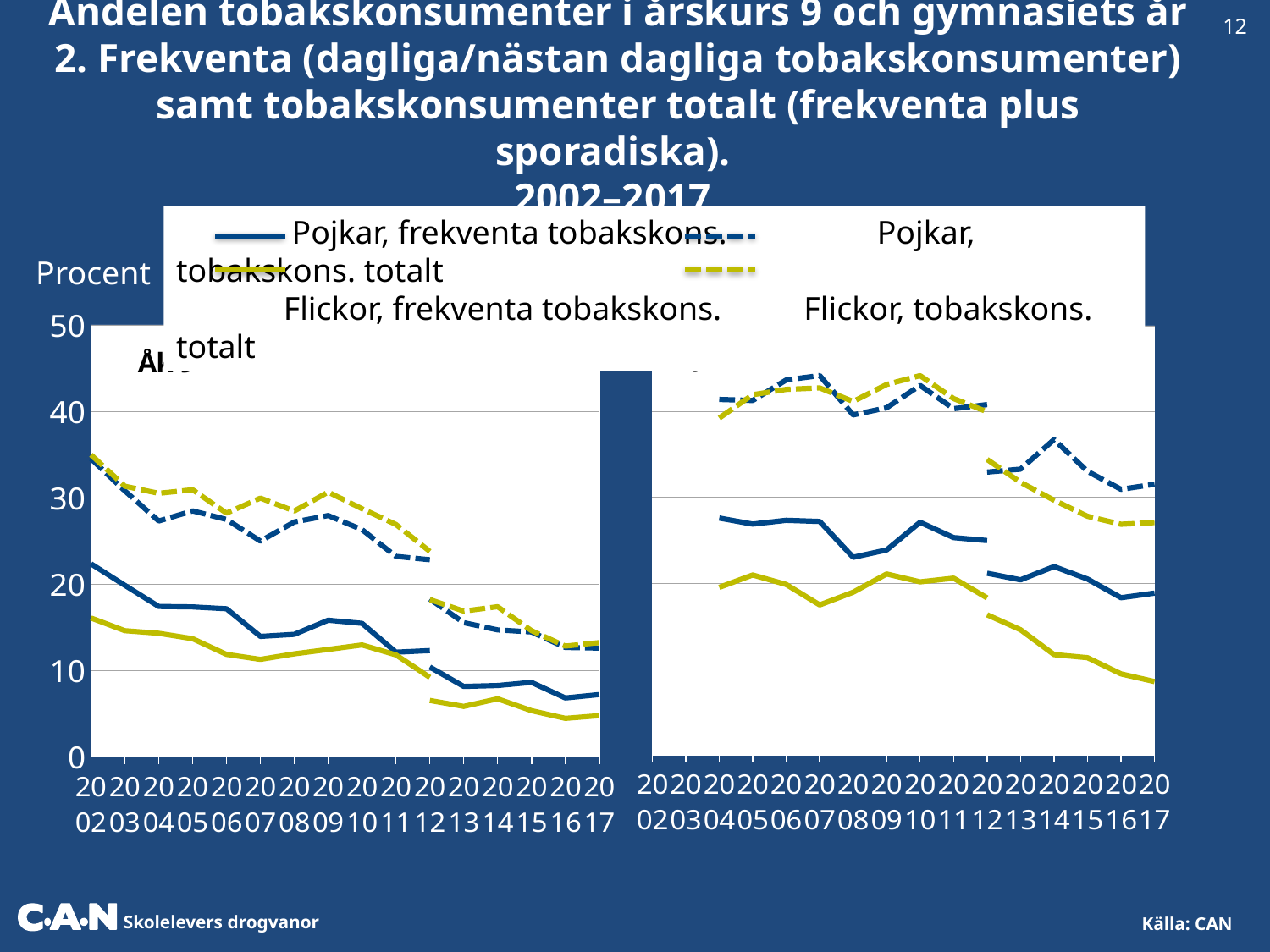
What is the label on the y axis of the charts? Procent In the left chart, is the value for Pojkar, tobakskons. totalt in 2002 greater or less than 30? greater What kind of chart is shown on the left side of the slide? Line chart In the left chart, does the Flickor, frekventa tobakskons. series rise or fall from 2002 to 2017? Fall What source is cited at the bottom of the slide? Källa: CAN In the right chart, is the value for Flickor, frekventa tobakskons. in 2017 greater or less than 10? less How many series does the legend list? 4 In the right chart, which series has the lowest value in 2017? Flickor, frekventa tobakskons. In the right chart, which is larger in 2017: Pojkar, frekventa tobakskons. or Flickor, frekventa tobakskons.? Pojkar, frekventa tobakskons. In the left chart, is the value for Flickor, frekventa tobakskons. in 2017 greater or less than 10? less How many years are plotted along the x axis of the left chart? 16